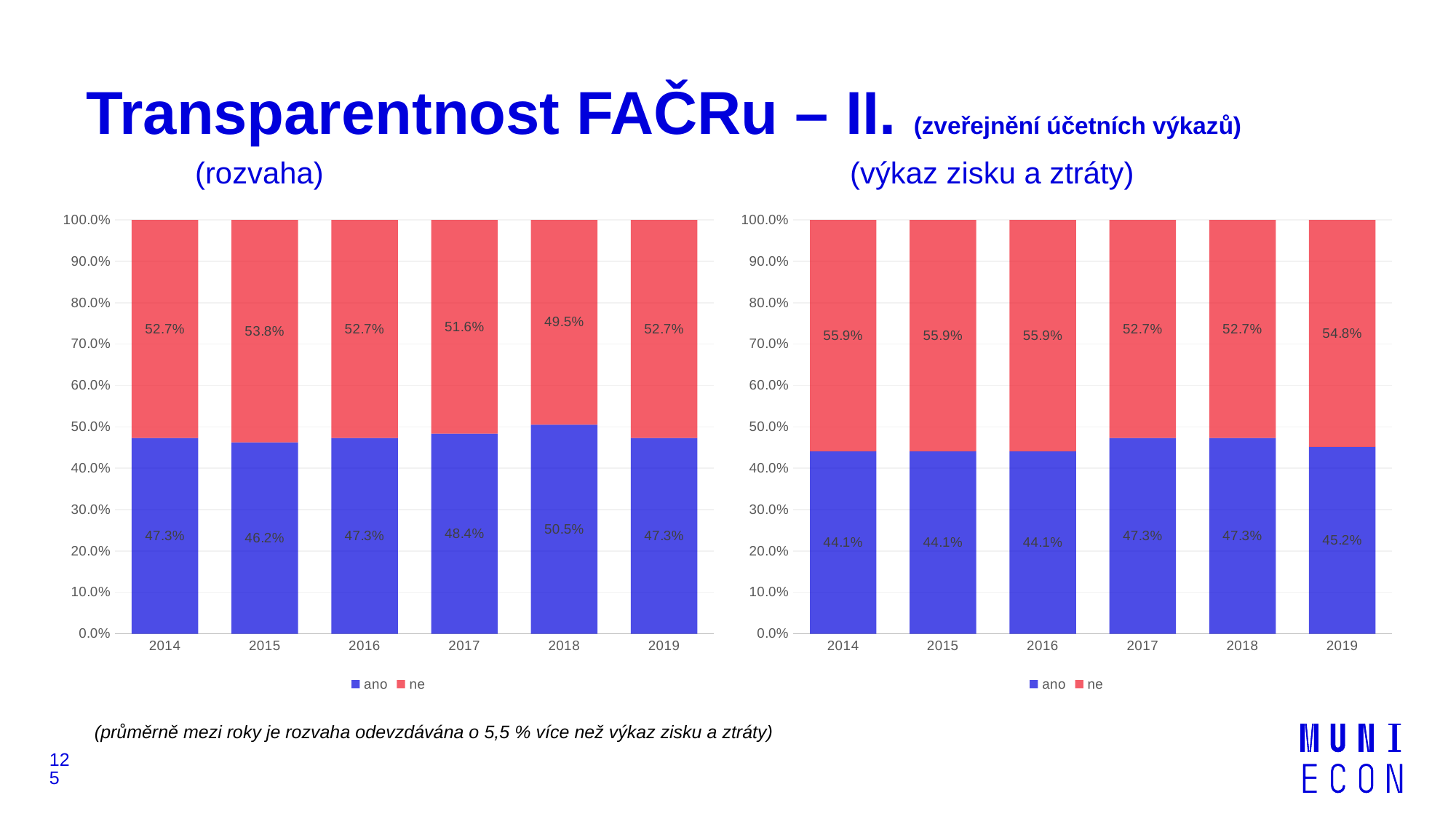
What colour represents the "ne" series in both charts? Red In the left chart (rozvaha), what is the value for "ano" in 2018? 50.5% In the right chart (výkaz zisku a ztráty), what is the difference between the "ne" and "ano" values in 2014? 11.8% What kind of chart is the left chart (rozvaha)? Stacked bar chart How many years are shown on the x axis of the left chart (rozvaha)? 6 In the right chart (výkaz zisku a ztráty), what is the total of the stacked bar for 2017? 100.0% In the right chart (výkaz zisku a ztráty), what is the value for "ne" in 2019? 54.8% In the left chart (rozvaha), which year has the highest "ano" value? 2018 In the right chart (výkaz zisku a ztráty), is the "ano" value for 2016 greater or less than 50%? less How many series does the legend of the right chart (výkaz zisku a ztráty) list? 2 In the left chart (rozvaha), is the "ano" value for 2017 larger than the "ano" value for 2015? Yes, 2017 (48.4%) is larger than 2015 (46.2%) In the left chart (rozvaha), which year has the lowest "ano" value? 2015